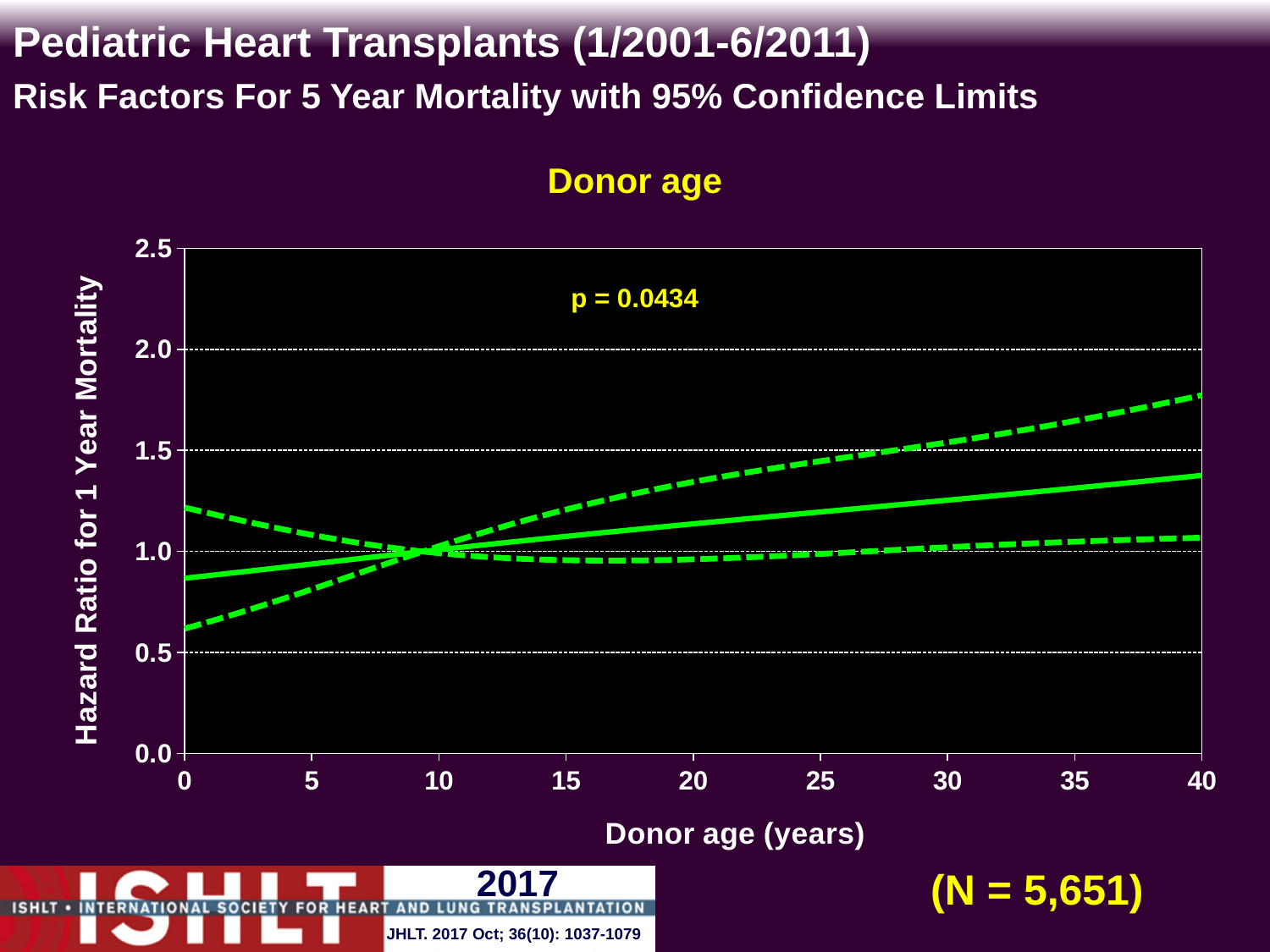
Is the value of the lower dashed confidence limit at donor age 0 greater or less than 0.5? greater Which is larger at donor age 40: the solid hazard ratio line or the upper dashed confidence limit? the upper dashed confidence limit Is the value of the solid hazard ratio line at donor age 0 greater or less than 1.0? less Is the value of the upper dashed confidence limit at donor age 40 greater or less than 1.5? greater How many lines are plotted on the chart? 3 What is the label of the y axis? Hazard Ratio for 1 Year Mortality What p-value is printed on the chart? p = 0.0434 What kind of chart is shown on the slide? line chart Does the solid hazard ratio line rise or fall as donor age increases from 0 to 40 years? rise